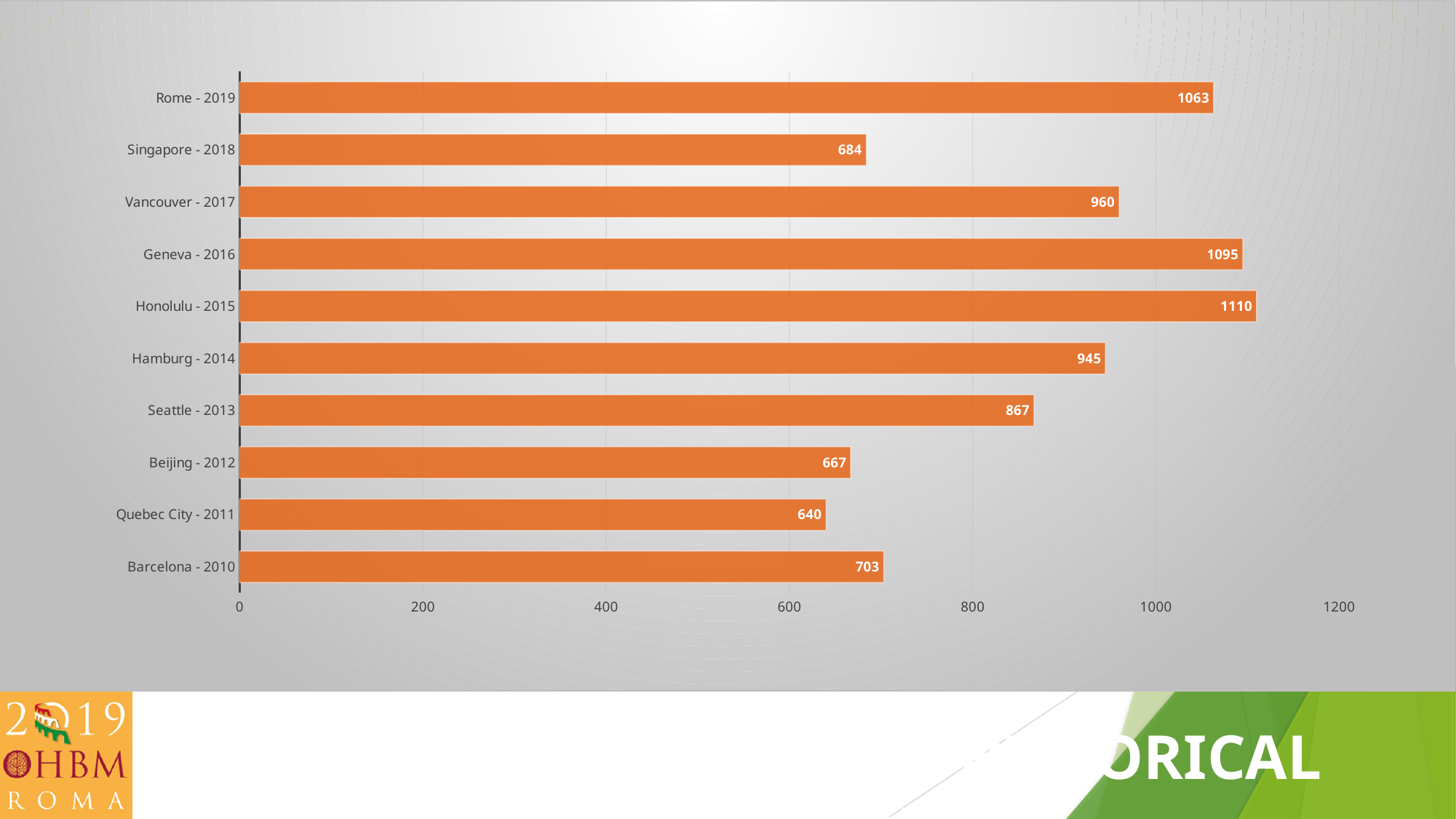
What is the difference between the values for Geneva - 2016 and Singapore - 2018? 411 Is the value for Seattle - 2013 greater or less than 800? greater What kind of chart is shown on the slide? bar chart How many categories are shown in the chart? 10 Which category has the lowest value? Quebec City - 2011 Which is larger, the value for Barcelona - 2010 or the value for Beijing - 2012? Barcelona - 2010 What colour are the bars in the chart? orange What is the difference between the values for Vancouver - 2017 and Seattle - 2013? 93 What is the value for Hamburg - 2014? 945 What is the value for Rome - 2019? 1063 What is the value for Quebec City - 2011? 640 Which category has the highest value? Honolulu - 2015